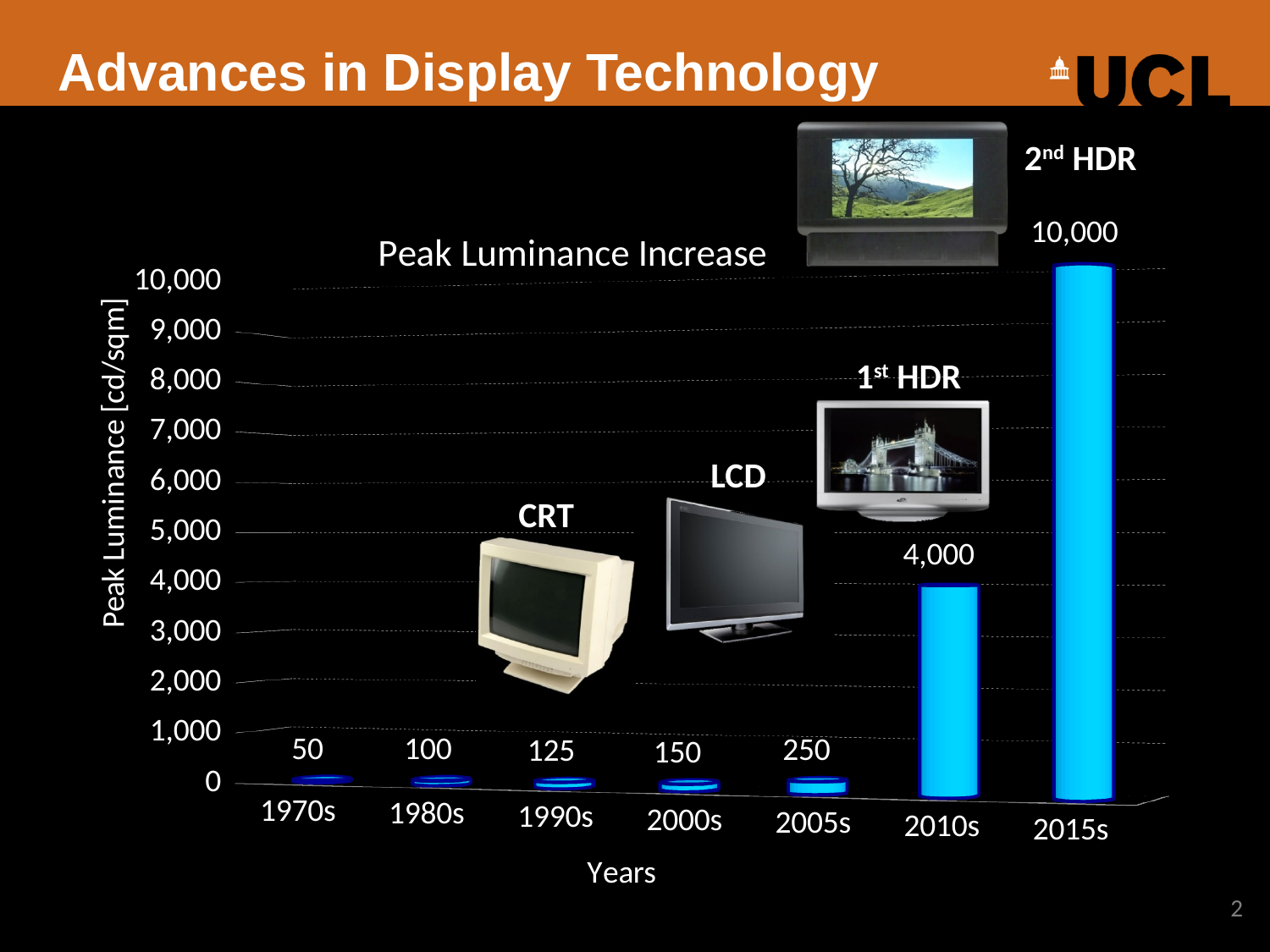
Which year category has the highest peak luminance? 2015s What is the peak luminance value for 2015s? 10,000 What is the difference in peak luminance between 2005s and 2000s? 100 What kind of chart is shown on the slide? bar chart How many year categories are shown on the x axis? 7 What is the title of the chart? Peak Luminance Increase What is the peak luminance value for 2005s? 250 What is the peak luminance value for 1970s? 50 Which has a higher peak luminance, 1990s or 1980s? 1990s What is the difference in peak luminance between 2015s and 2010s? 6,000 What is the peak luminance value for 2010s? 4,000 Which year category has the lowest peak luminance? 1970s